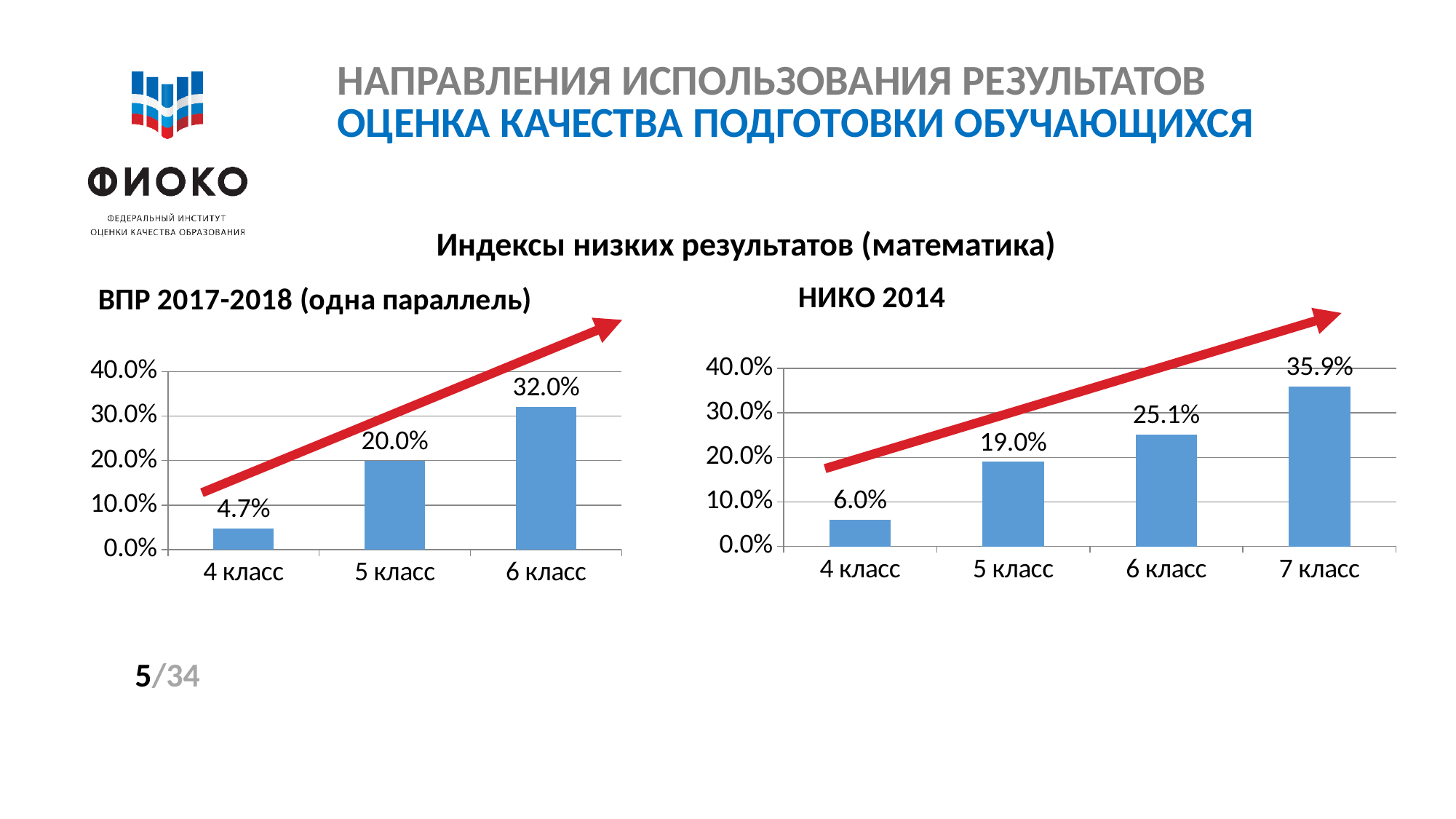
In the НИКО 2014 chart, what is the difference between the values for 7 класс and 4 класс? 29.9% In the ВПР 2017-2018 (одна параллель) chart, what is the value for 4 класс? 4.7% In the НИКО 2014 chart, which class has the lowest value? 4 класс In the ВПР 2017-2018 (одна параллель) chart, what is the value for 6 класс? 32.0% What kind of chart is the ВПР 2017-2018 (одна параллель) chart? Bar chart In the ВПР 2017-2018 (одна параллель) chart, which class has the highest value? 6 класс Which is larger: the value for 5 класс in the ВПР 2017-2018 chart or the value for 5 класс in the НИКО 2014 chart? ВПР 2017-2018 (20.0%) How many classes are shown in the НИКО 2014 chart? 4 In the НИКО 2014 chart, what is the value for 7 класс? 35.9% In the НИКО 2014 chart, what is the value for 6 класс? 25.1% In the НИКО 2014 chart, do the values rise or fall from 4 класс to 7 класс? Rise In the ВПР 2017-2018 (одна параллель) chart, what is the difference between the values for 6 класс and 5 класс? 12.0%